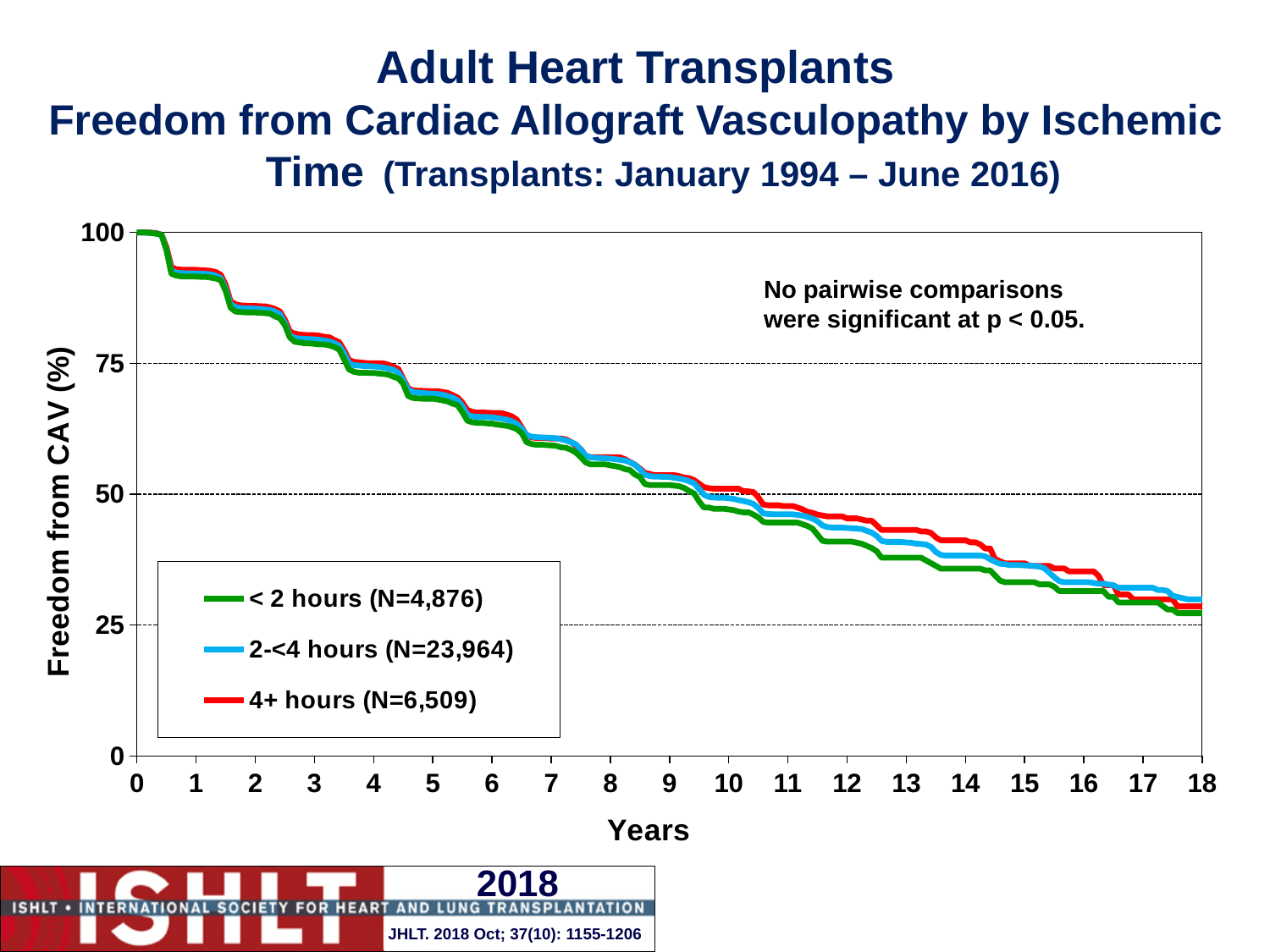
What is the freedom from CAV (%) for all three groups at year 0? 100 According to the legend, how many transplants are in the 2-<4 hours group? N=23,964 Which ischemic time group has the lowest freedom from CAV at year 13? < 2 hours Is the freedom from CAV for the 2-<4 hours group at year 5 greater or less than 50? greater How many series does the legend list? 3 Is the freedom from CAV for the 4+ hours group at year 5 greater or less than 75? less Is the freedom from CAV for the < 2 hours group at year 15 greater or less than 50? less What does the annotation on the chart say about pairwise comparisons? No pairwise comparisons were significant at p < 0.05. Do the freedom from CAV values rise or fall as years increase? fall At year 12, which group has the higher freedom from CAV: < 2 hours or 4+ hours? 4+ hours What kind of chart is shown on the slide? line chart